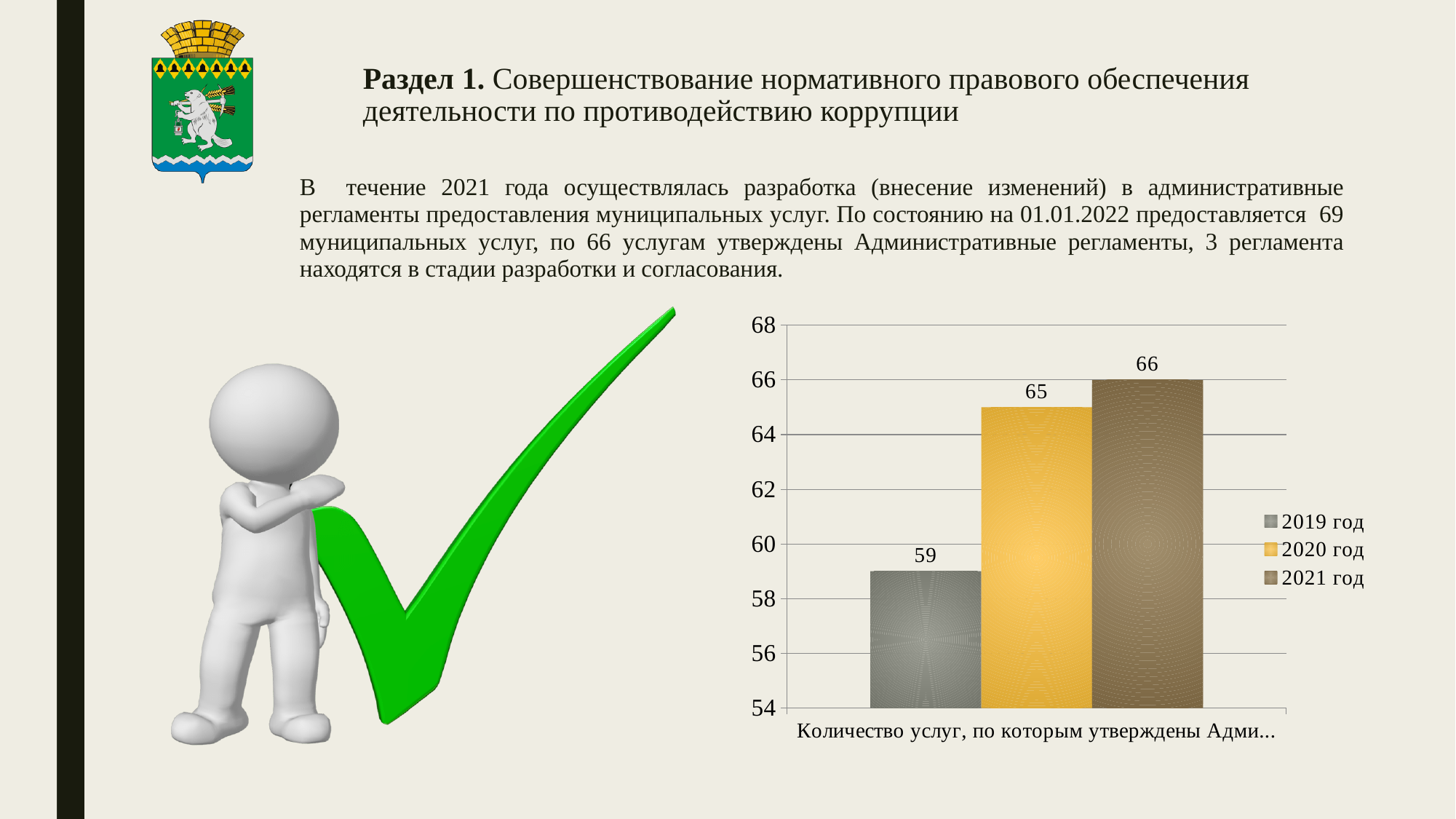
What is the difference between the values for 2021 год and 2019 год? 7 Do the values rise or fall from 2019 год to 2021 год? rise What is the value for 2020 год in the chart? 65 Which series has the lowest value in the chart? 2019 год Which is larger, the value for 2019 год or the value for 2020 год? 2020 год How many series does the legend list? 3 What is the value for 2021 год in the chart? 66 Which series has the highest value in the chart? 2021 год What kind of chart is shown on the slide? bar chart Is the value for 2019 год greater or less than 60? less What is the difference between the values for 2020 год and 2019 год? 6 What is the value for 2019 год in the chart? 59